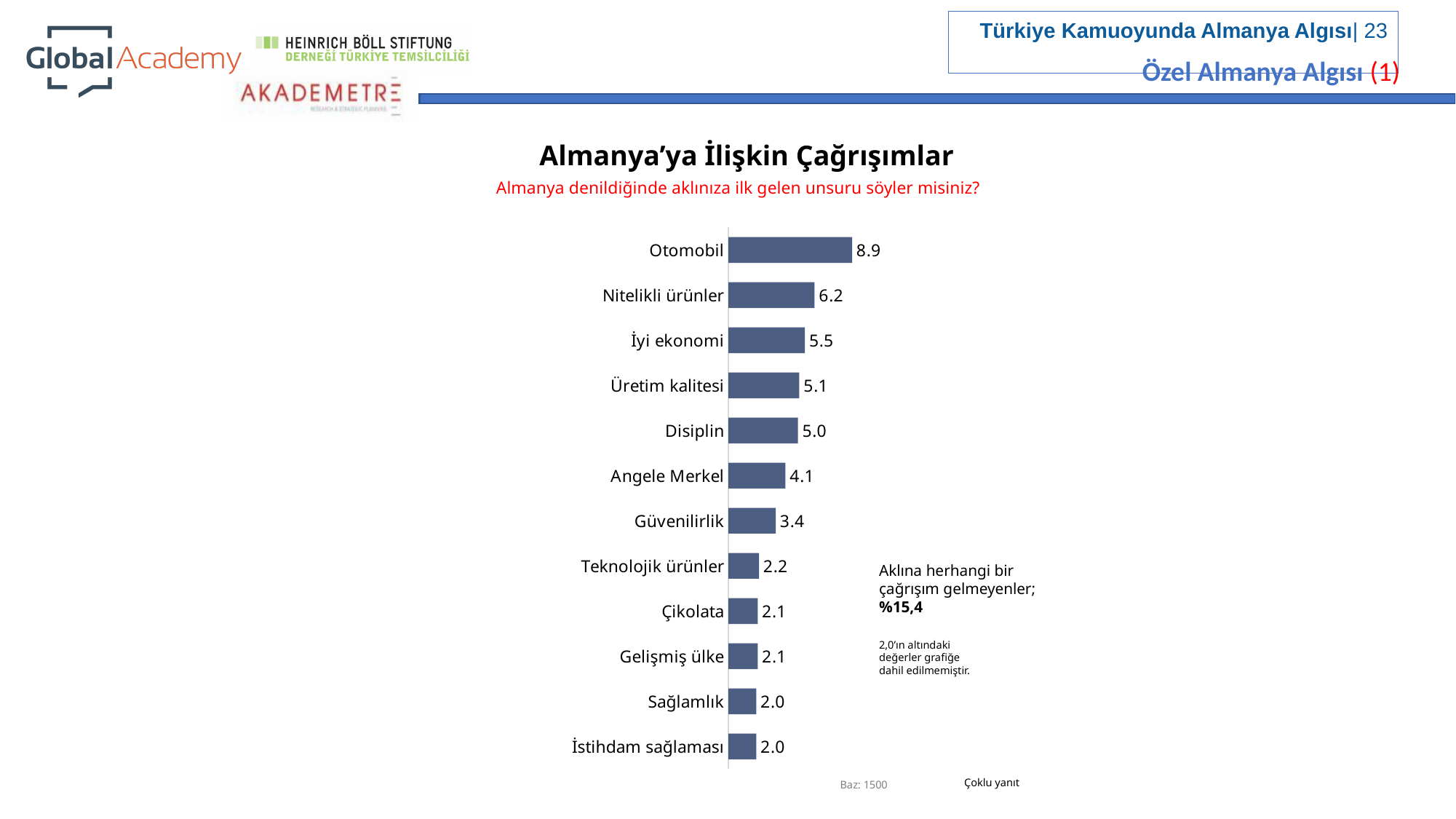
What kind of chart is shown on the slide? Bar chart What is the value for Güvenilirlik? 3.4 What is the title of the chart? Almanya'ya İlişkin Çağrışımlar Which category has the highest value? Otomobil What is the difference between the values for Otomobil and Nitelikli ürünler? 2.7 Which is larger, the value for Üretim kalitesi or the value for Teknolojik ürünler? Üretim kalitesi What is the value for Çikolata? 2.1 What is the difference between the values for İyi ekonomi and Disiplin? 0.5 What is the base (Baz) sample size noted below the chart? 1500 What is the value for Angele Merkel? 4.1 How many categories are shown in the chart? 12 What is the value for Otomobil? 8.9